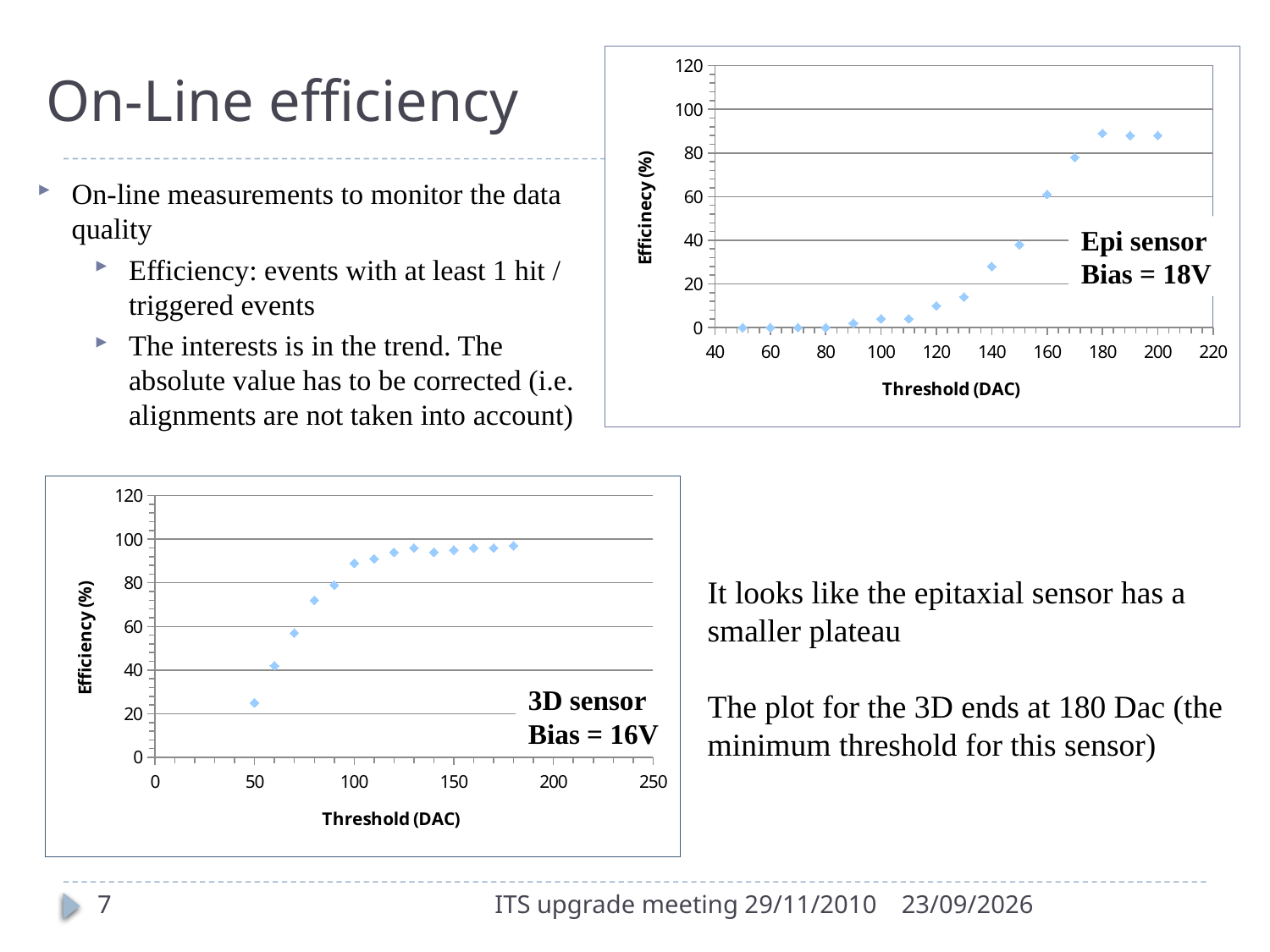
In the top-right chart (Epi sensor), which threshold has the higher efficiency, 140 DAC or 180 DAC? 180 DAC In the top-right chart (Epi sensor), is the efficiency at a threshold of 100 DAC greater or less than 20? less In the bottom-left chart (3D sensor), which threshold has the higher efficiency, 50 DAC or 150 DAC? 150 DAC In the bottom-left chart (3D sensor), do the efficiency values rise or fall as the threshold increases? rise In the top-right chart (Epi sensor), is the efficiency at a threshold of 140 DAC greater or less than 40? less How many data points are plotted in the bottom-left chart (3D sensor)? 14 In the top-right chart (Epi sensor), do the efficiency values rise or fall as the threshold increases? rise In the bottom-left chart (3D sensor), is the efficiency at a threshold of 100 DAC greater or less than 80? greater What is the x-axis title of the top-right chart (Epi sensor)? Threshold (DAC) What kind of chart is the top-right chart labelled 'Epi sensor Bias = 18V'? scatter chart